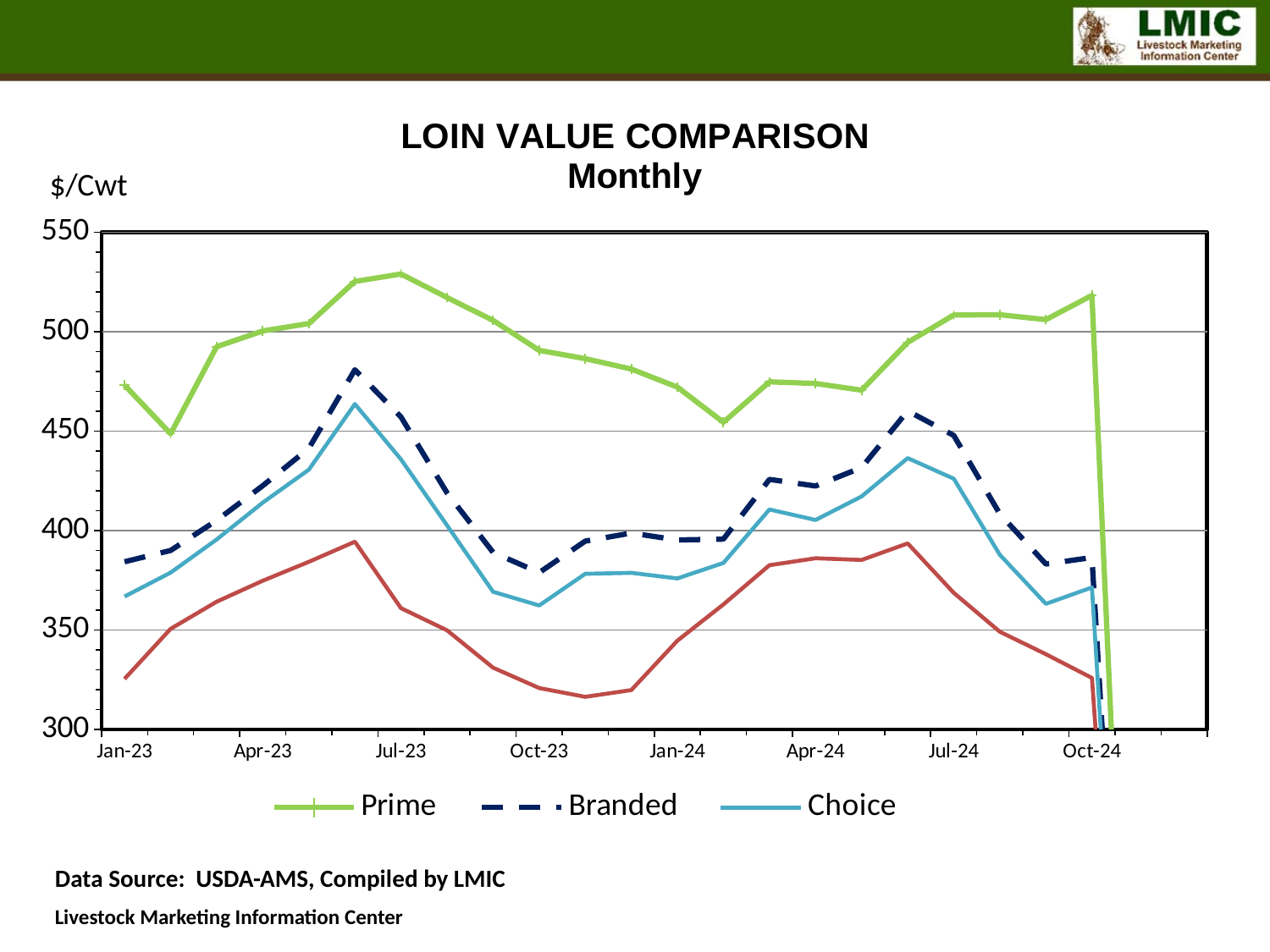
Does the Choice series rise or fall between Jul-23 and Oct-23? Fall Is the value for Branded at Jan-23 greater or less than 400? less How many series does the legend list? 3 At Jan-24, which is larger, Branded or Choice? Branded Is the value for Choice at Oct-23 greater or less than 400? less Is the value for Prime at Jul-23 greater or less than 500? greater What unit is shown on the y axis of the chart? $/Cwt Which series has the highest values across the whole period shown? Prime What kind of chart is shown on the slide? Line chart What is the title of the chart? LOIN VALUE COMPARISON Monthly